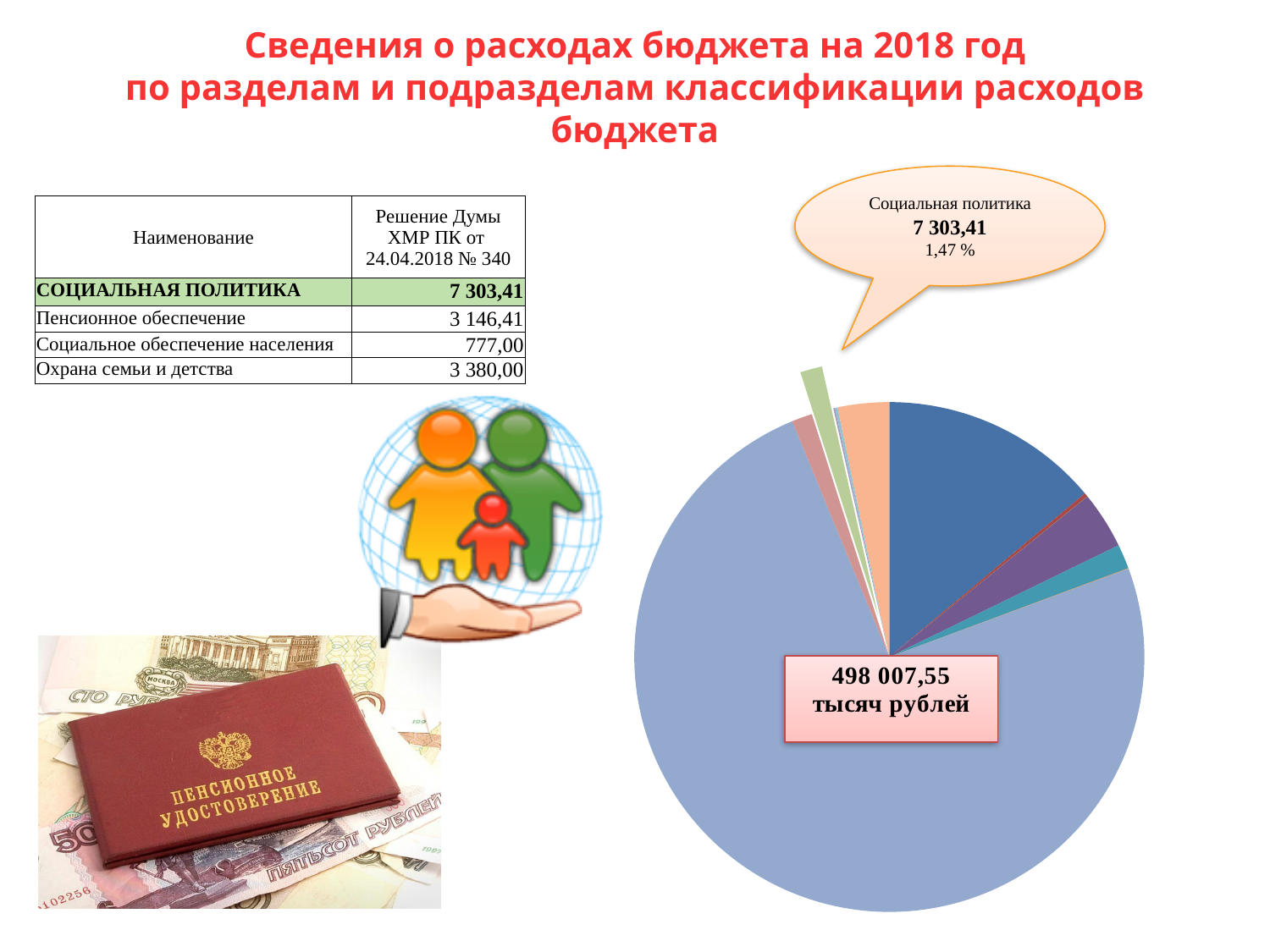
What kind of chart is shown on the right side of the slide? pie chart Which category does the callout on the pie chart point to? Социальная политика Is the share of Социальная политика in the pie chart greater or less than 5%? less What share of the pie does the callout give for Социальная политика? 1,47 % What colour is the exploded slice of the pie chart that the callout points to? green What value does the callout on the pie chart give for Социальная политика? 7 303,41 What total is printed in the box at the centre of the pie chart? 498 007,55 тысяч рублей